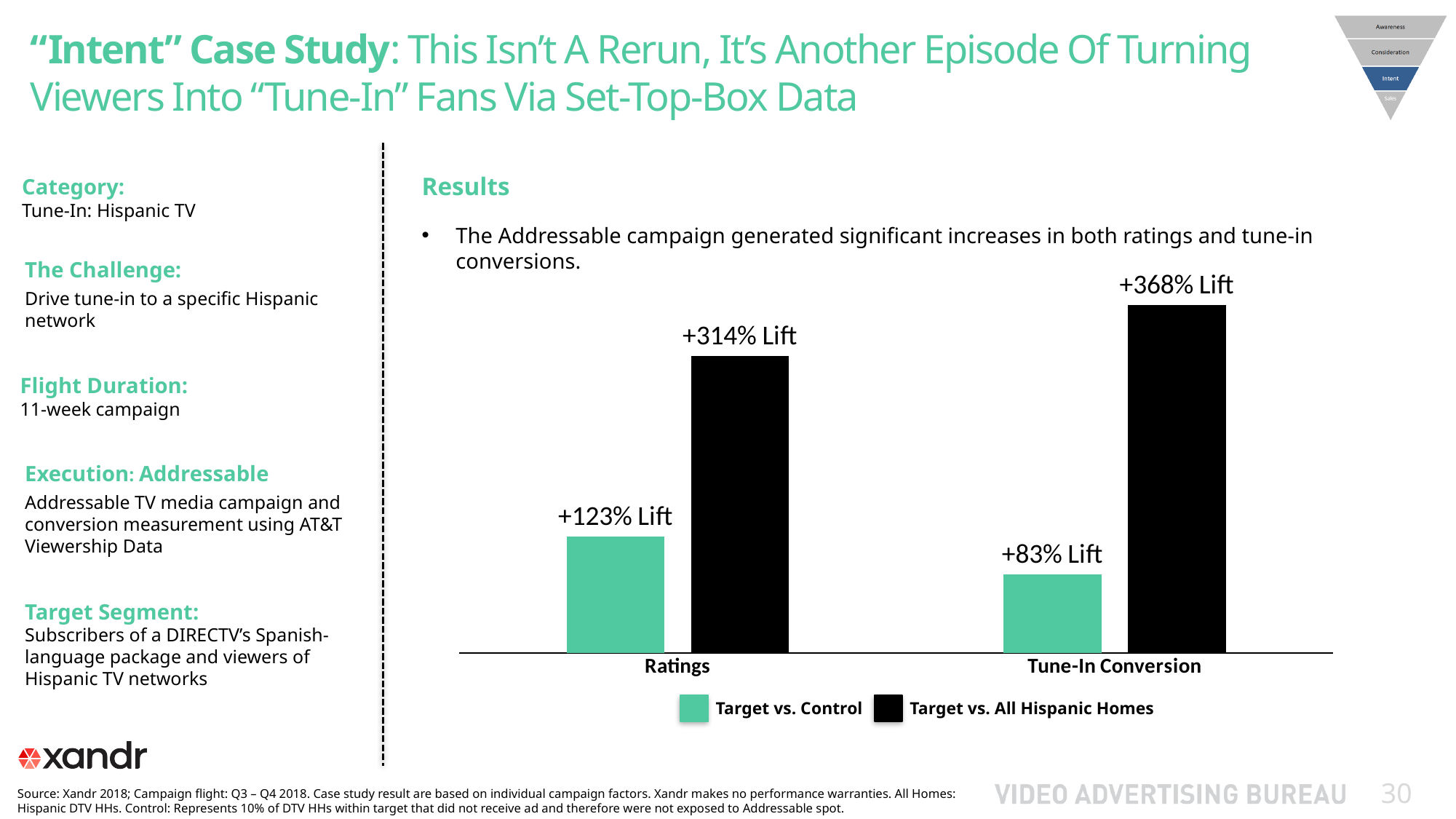
What is the difference between the Target vs. All Hispanic Homes lift for Tune-In Conversion and for Ratings? 54% How many series does the chart legend list? 2 What is the difference between the Target vs. All Hispanic Homes lift and the Target vs. Control lift for Ratings? 191% How many categories are shown on the x axis of the chart? 2 What is the Target vs. All Hispanic Homes lift for Tune-In Conversion? +368% Lift What is the Target vs. Control lift for Ratings? +123% Lift Which bar shows the highest lift on the chart? Target vs. All Hispanic Homes for Tune-In Conversion What is the Target vs. Control lift for Tune-In Conversion? +83% Lift What type of chart is shown on the slide? Bar chart What is the Target vs. All Hispanic Homes lift for Ratings? +314% Lift Which bar shows the lowest lift on the chart? Target vs. Control for Tune-In Conversion Which is larger: the Target vs. Control lift for Ratings or for Tune-In Conversion? Ratings